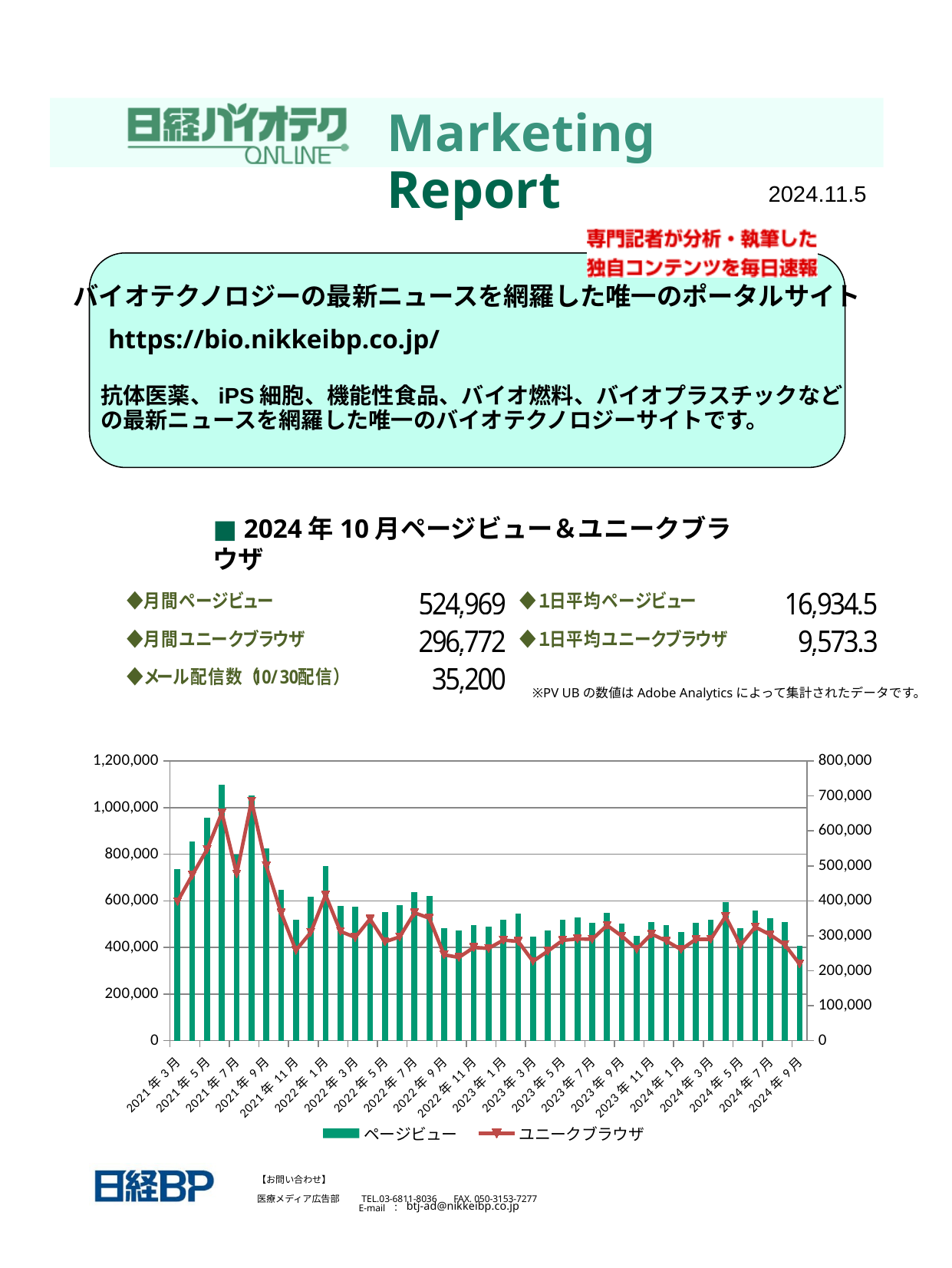
What kind of chart is shown on the slide? Combined bar and line chart Which has the larger ページビュー value, 2021年5月 or 2023年5月? 2021年5月 Is the ページビュー value for 2021年7月 greater or less than 1,000,000? less Is the ユニークブラウザ value for 2023年3月 greater or less than 300,000 on the right axis? less Is the ページビュー value for 2021年3月 greater or less than 600,000? greater Do the ページビュー values generally rise or fall from 2021年7月 to 2021年11月? fall How many series does the chart legend list? 2 What are the two legend entries of the chart? ページビュー and ユニークブラウザ What is the maximum value shown on the right-hand axis of the chart? 800,000